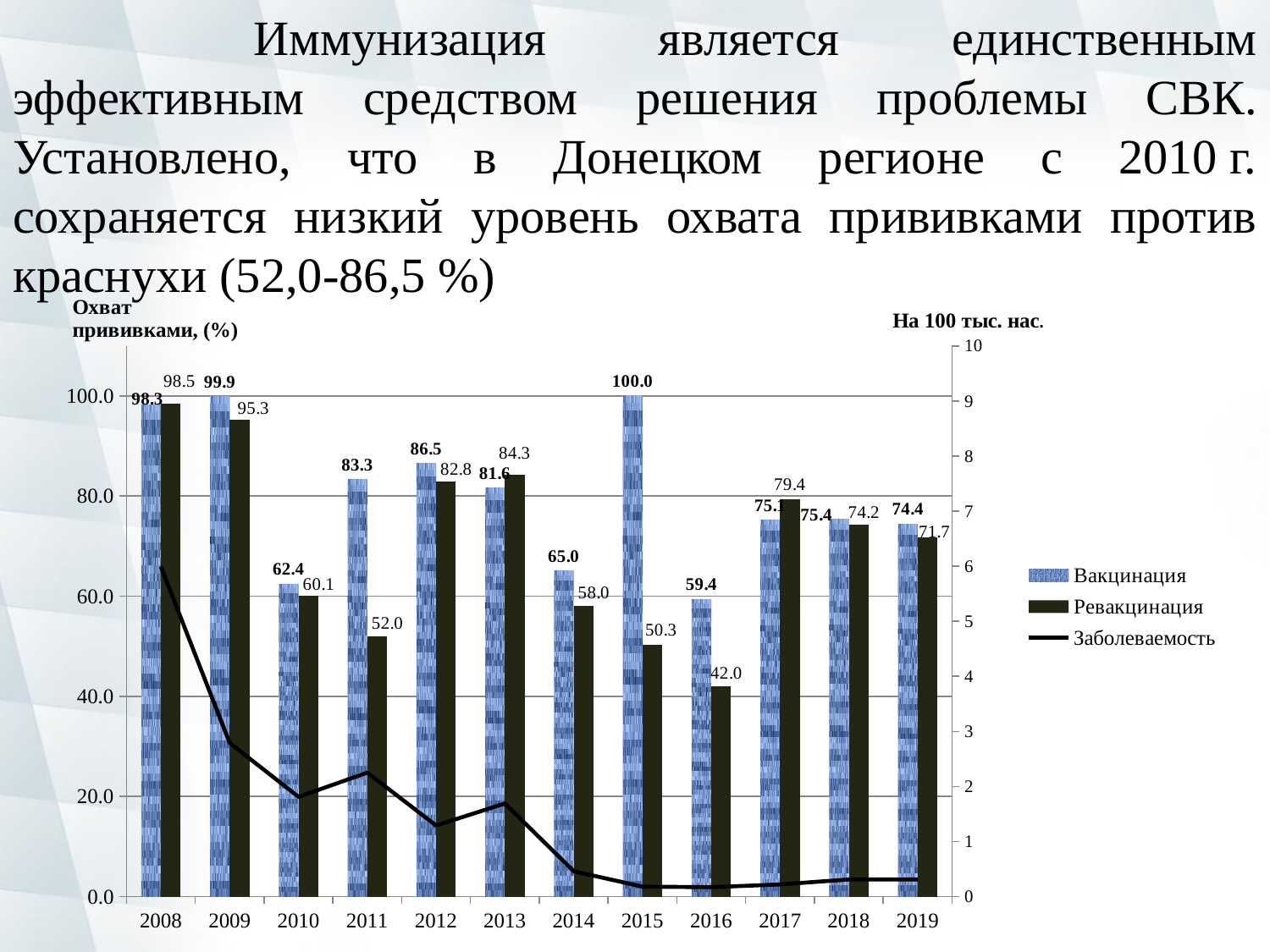
How many years are shown on the x axis? 12 What is the value of Ревакцинация for 2017? 79.4 Is the Заболеваемость value for 2015 greater or less than 1 on the right axis? less What is the difference between Вакцинация and Ревакцинация in 2011? 31.3 How many series does the legend list? 3 What is the value of Вакцинация for 2015? 100.0 What is the value of Ревакцинация for 2016? 42.0 Is the Заболеваемость value for 2008 greater or less than 5 on the right axis? greater In which year is the Ревакцинация value lowest? 2016 In 2013, which is larger: Вакцинация or Ревакцинация? Ревакцинация Does the Заболеваемость line overall rise or fall from 2008 to 2019? fall In which year is the Вакцинация value highest? 2015